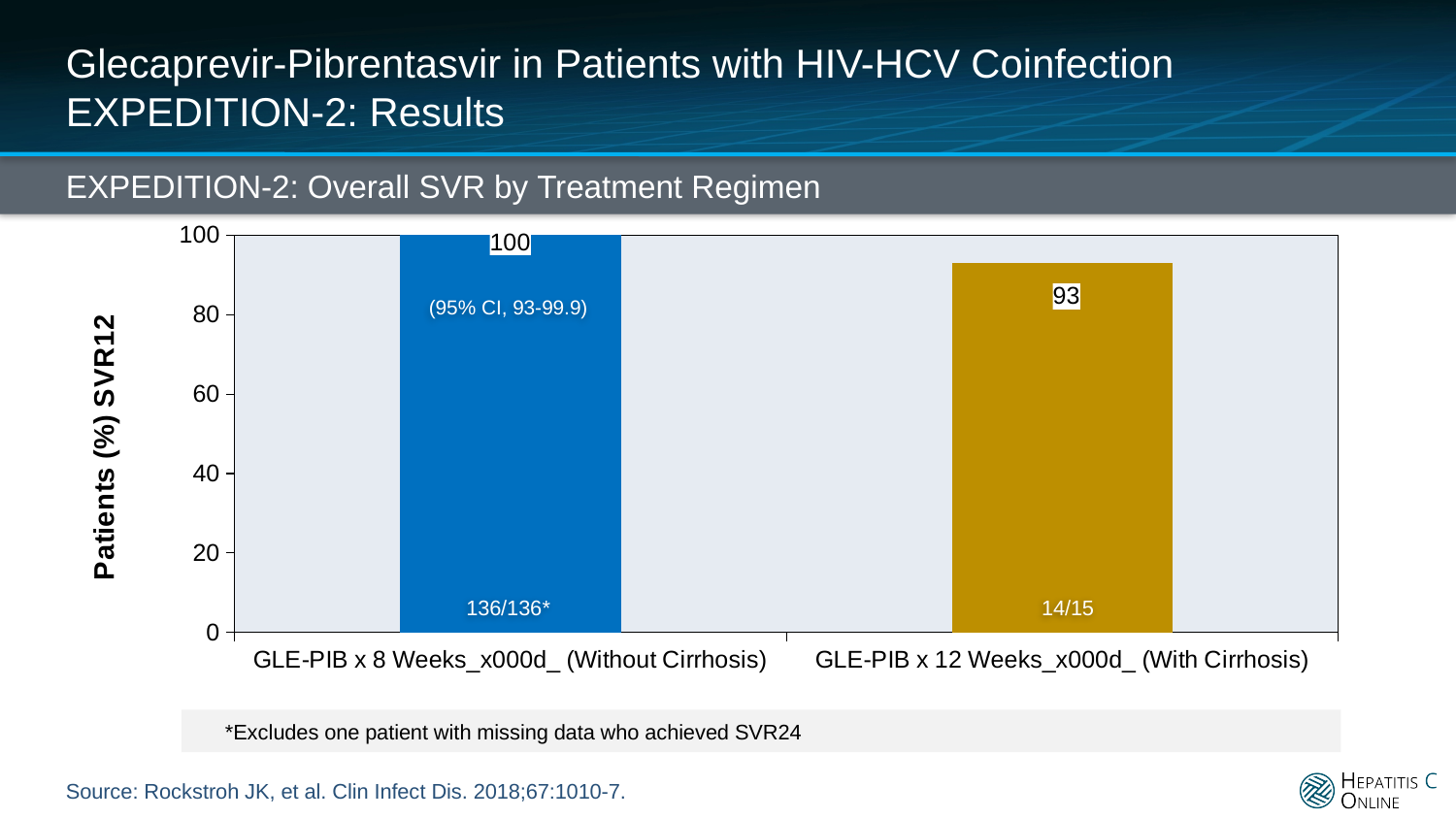
Is the value for GLE-PIB x 12 Weeks (With Cirrhosis) greater or less than 80? greater What patient fraction is shown for the GLE-PIB x 8 Weeks bar? 136/136* How many treatment regimens are shown in the chart? 2 What kind of chart is shown on the slide? Bar chart What is the SVR12 value for GLE-PIB x 8 Weeks (Without Cirrhosis)? 100 What is the title of the chart? EXPEDITION-2: Overall SVR by Treatment Regimen What patient fraction is shown for the GLE-PIB x 12 Weeks bar? 14/15 Which treatment regimen has the lowest SVR12 value? GLE-PIB x 12 Weeks (With Cirrhosis) Which has a larger SVR12 value: GLE-PIB x 8 Weeks or GLE-PIB x 12 Weeks? GLE-PIB x 8 Weeks Which treatment regimen has the highest SVR12 value? GLE-PIB x 8 Weeks (Without Cirrhosis) What is the difference in SVR12 between the 8-week and 12-week regimens? 7 What is the SVR12 value for GLE-PIB x 12 Weeks (With Cirrhosis)? 93